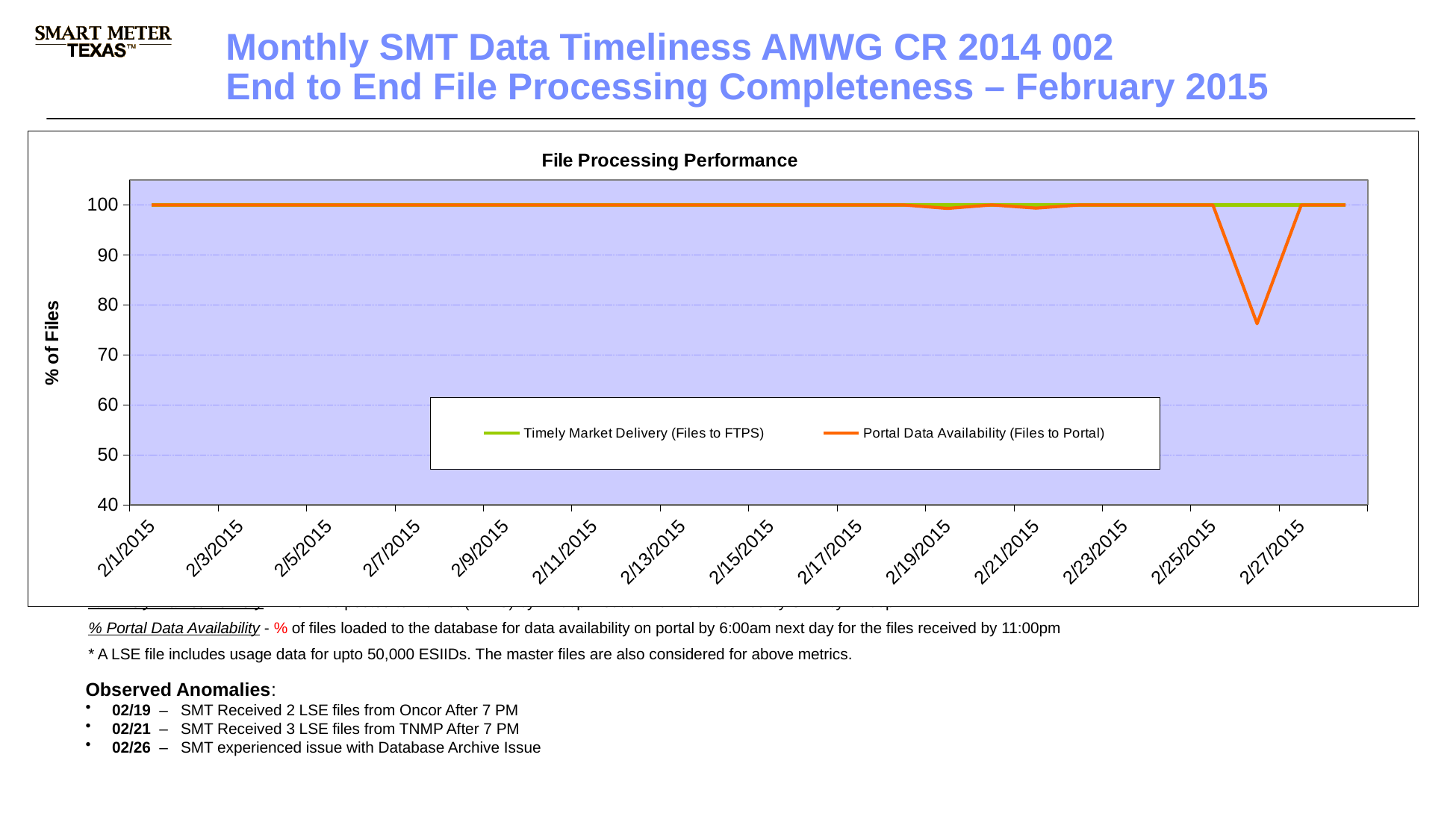
What is the lowest value shown on the y axis? 40 At the point where the Portal Data Availability line dips sharply, which series has the higher value? Timely Market Delivery (Files to FTPS) What is the title of the chart? File Processing Performance Does the Timely Market Delivery (Files to FTPS) line ever drop below 90 during the month? No Is the lowest value of the Portal Data Availability (Files to Portal) line greater or less than 70? greater Which series is drawn in orange in the chart? Portal Data Availability (Files to Portal) How many series does the chart legend list? 2 Is the lowest value of the Portal Data Availability (Files to Portal) line greater or less than 80? less What kind of chart is shown on the slide? line chart What is the highest value shown on the y axis? 100 What is the label of the y axis? % of Files How many date labels are shown on the x axis? 14